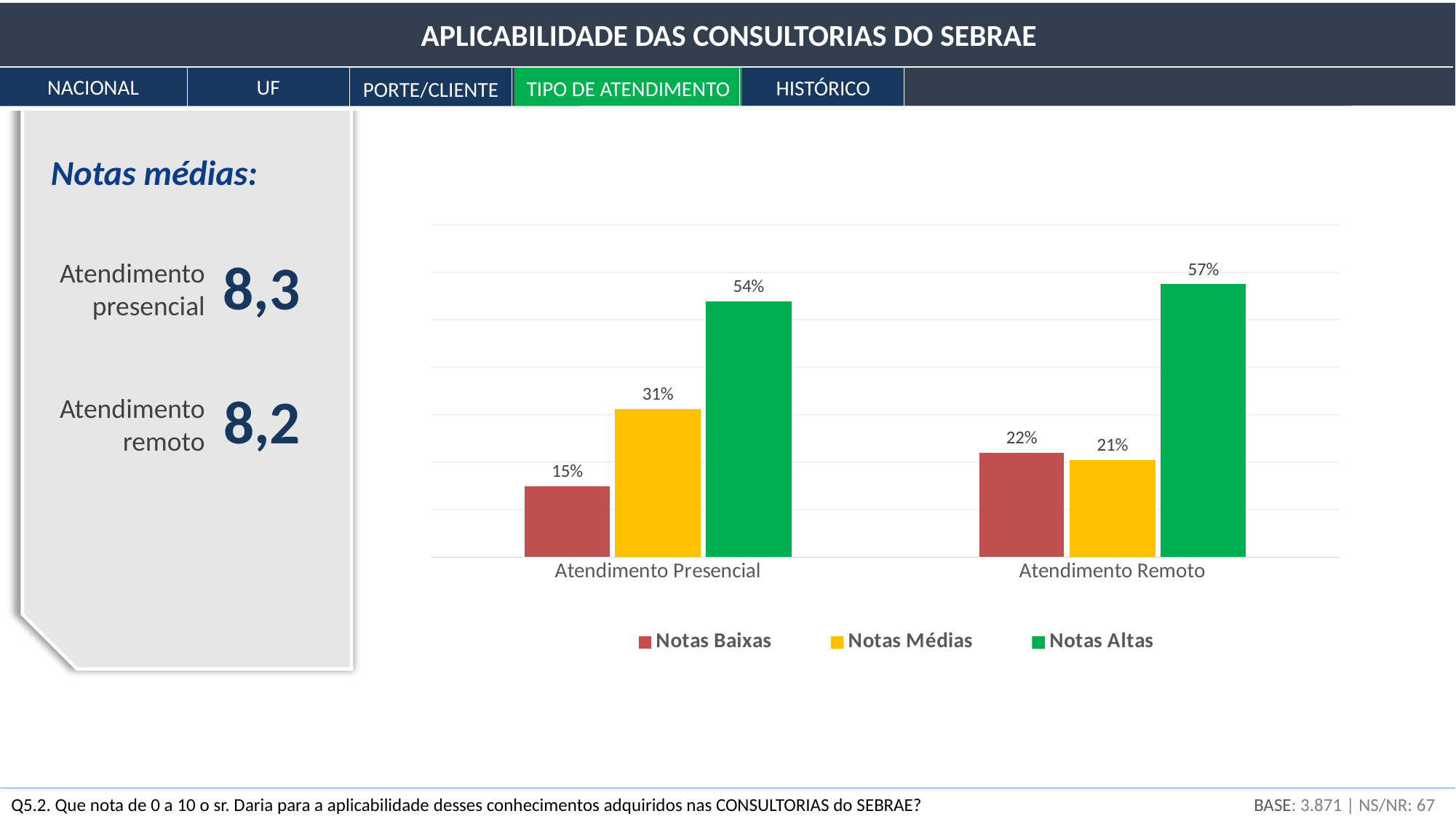
What colour represents Notas Altas in the chart? Green What kind of chart is shown on the slide? Bar chart How many series does the legend list? 3 How many categories are shown on the x axis of the chart? 2 Which series has the lowest value in Atendimento Presencial? Notas Baixas What is the value for Notas Baixas in Atendimento Remoto? 22% What is the value for Notas Altas in Atendimento Presencial? 54% What is the value for Notas Médias in Atendimento Presencial? 31% What is the difference between Notas Altas in Atendimento Remoto and Notas Altas in Atendimento Presencial? 3% What is the value for Notas Médias in Atendimento Remoto? 21% Which is larger: Notas Médias in Atendimento Presencial or Notas Médias in Atendimento Remoto? Atendimento Presencial Which series has the highest value in Atendimento Remoto? Notas Altas